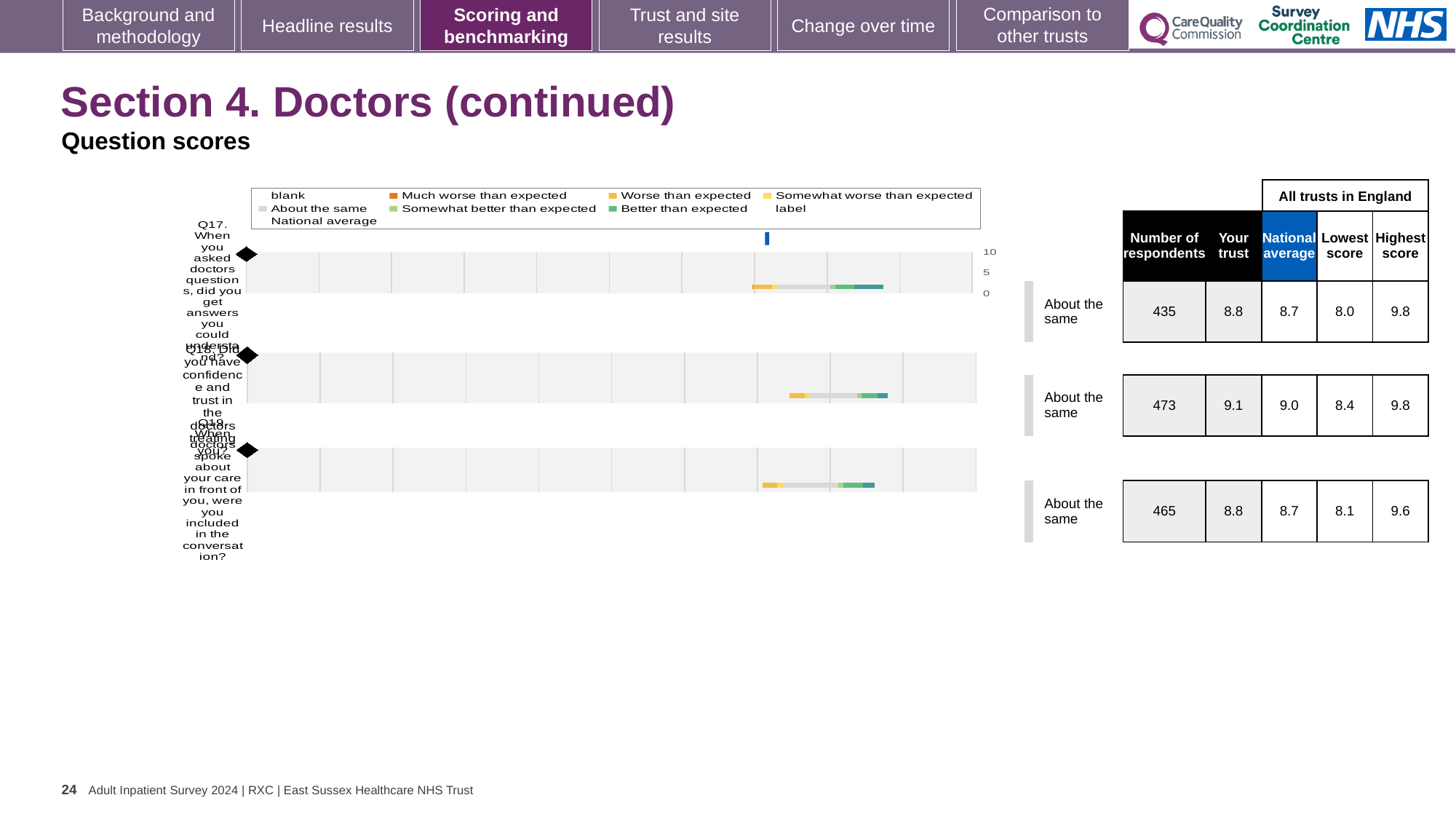
What is the national average score for Q17? 8.7 Which colour does the legend use for 'Much worse than expected'? orange What is the difference between the 'Your trust' score and the national average for Q18? 0.1 Which question has the lowest 'Lowest score' across all trusts in England? Q17 What is the 'Your trust' score for Q18 (confidence and trust in doctors)? 9.1 What is the highest score across all trusts in England for Q19? 9.6 How many respondents answered Q19? 465 How many questions (categories) are plotted in the chart? 3 Which question has the highest 'Your trust' score? Q18 What benchmark category is shown next to each of the three question bars? About the same For Q17, which is larger: the 'Your trust' score or the national average? Your trust What kind of chart is used to show the question scores on this slide? bar chart